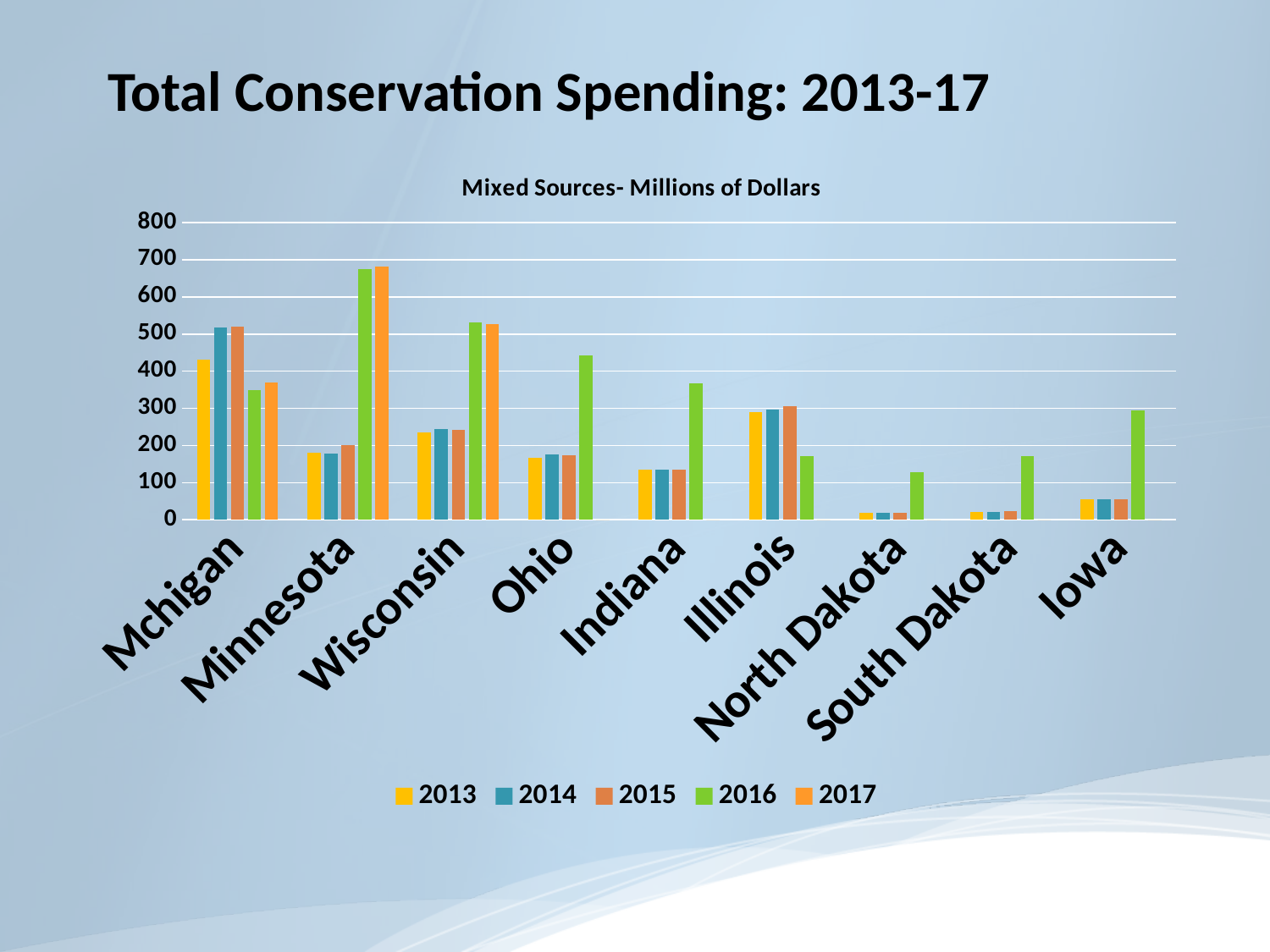
Which state has the highest 2016 value? Minnesota Is the 2016 value for Ohio greater or less than 400? greater Is the 2016 value for Illinois greater or less than 200? less Which is larger, the 2013 value for Mchigan or the 2013 value for Minnesota? Mchigan Is the 2013 value for North Dakota greater or less than 100? less How many series does the legend list? 5 Which is larger, the 2016 value for Wisconsin or the 2016 value for Ohio? Wisconsin Which state has the lowest 2016 value? North Dakota How many states are shown on the x axis of the chart? 9 What kind of chart is shown on the slide? bar chart What is the subtitle printed above the chart? Mixed Sources- Millions of Dollars